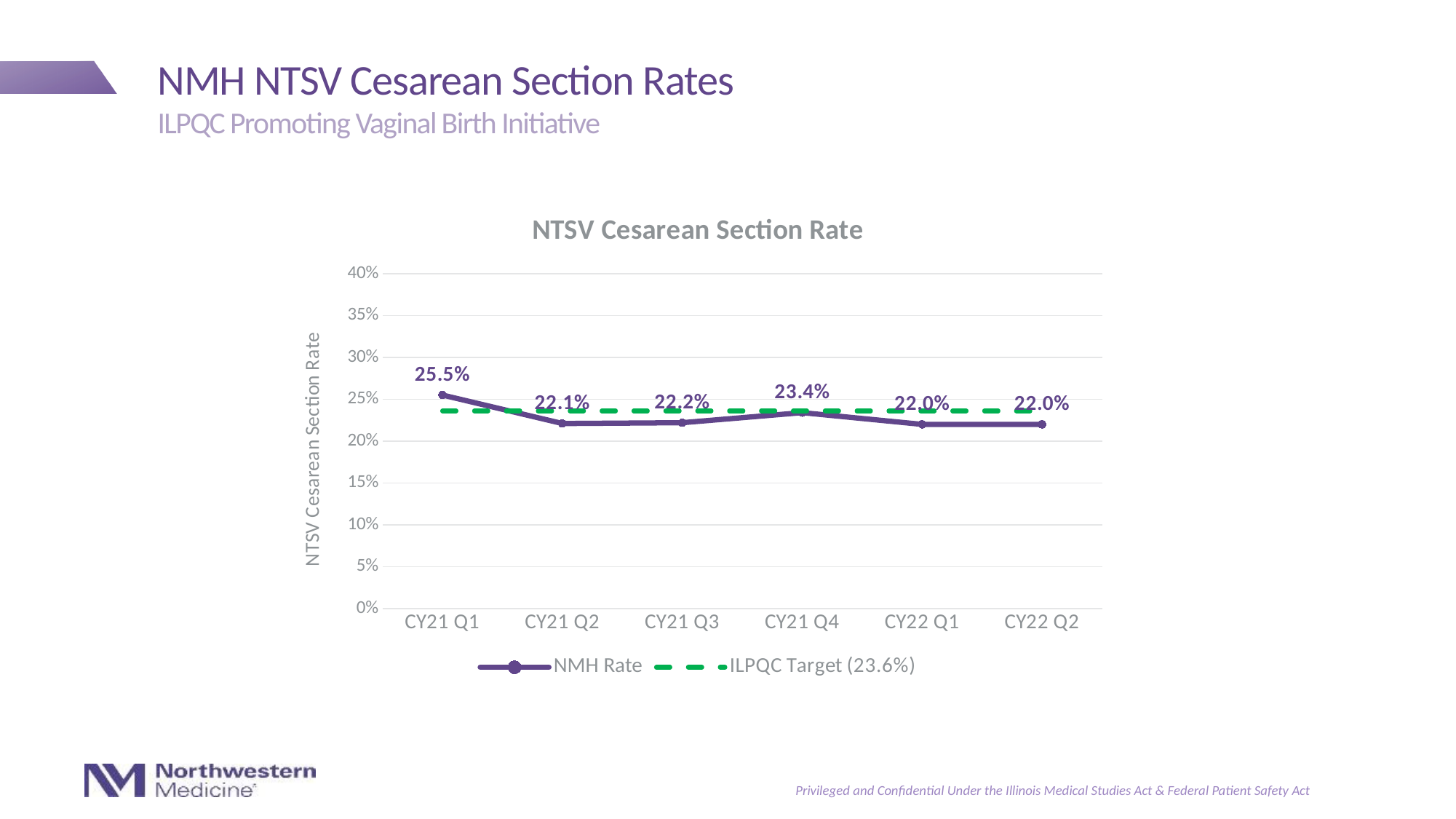
What is the title of the chart? NTSV Cesarean Section Rate What is the NMH Rate for CY21 Q1? 25.5% How many series does the legend list? 2 Which quarter has the highest NMH Rate? CY21 Q1 What is the difference between the NMH Rate in CY21 Q1 and CY21 Q2? 3.4% How many quarters are plotted on the x axis? 6 Is the NMH Rate for CY21 Q1 greater or less than 25%? greater What kind of chart is shown? line chart What is the NMH Rate for CY21 Q4? 23.4% Which is larger, the NMH Rate in CY21 Q4 or in CY21 Q3? CY21 Q4 What is the ILPQC Target value shown in the legend? 23.6% What is the NMH Rate for CY22 Q2? 22.0%